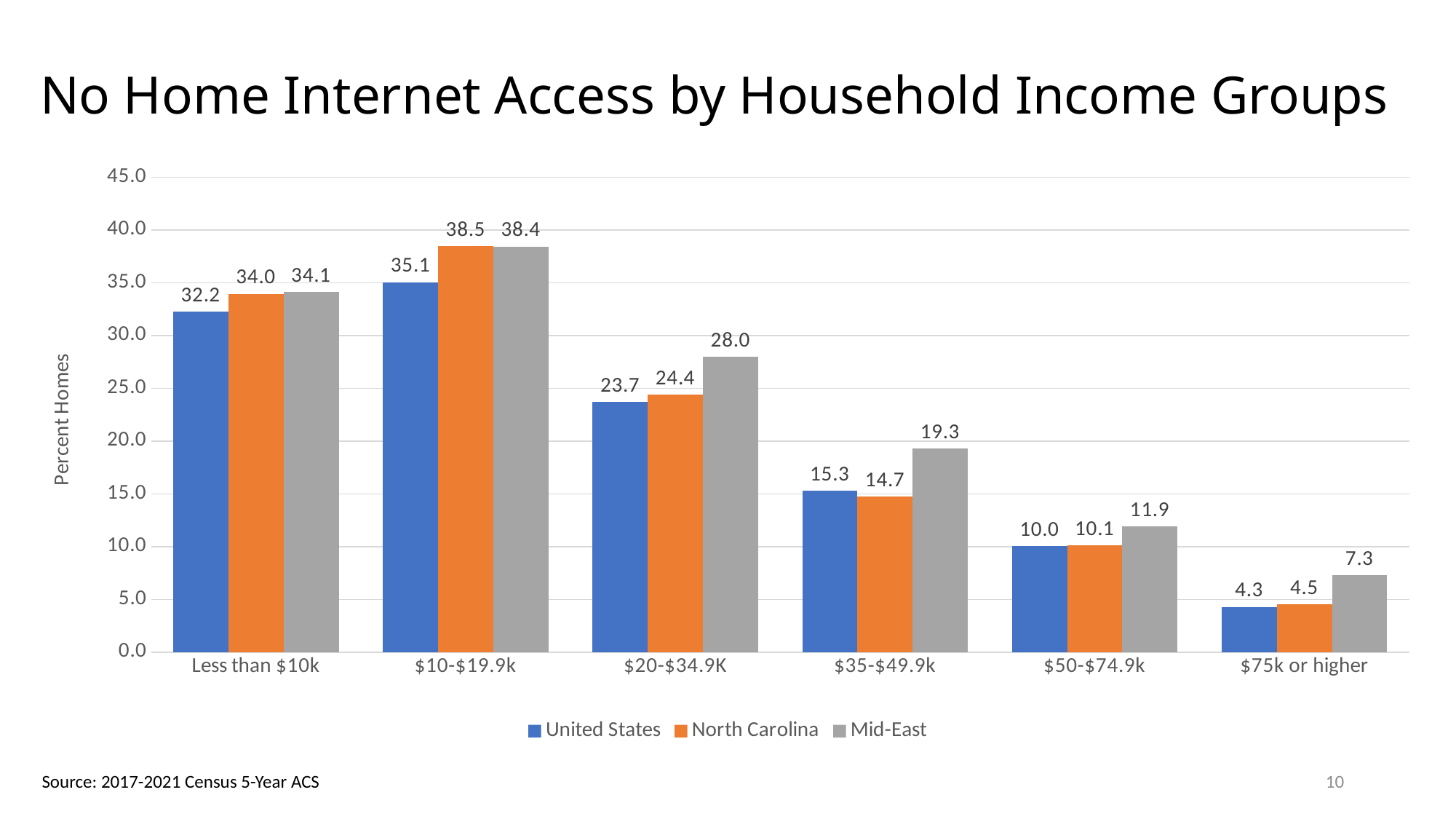
Which income group has the lowest value for the Mid-East series? $75k or higher How many series does the legend list? 3 Which income group has the highest value for the United States series? $10-$19.9k What is the value for North Carolina in the $20-$34.9K income group? 24.4 What is the value for United States in the $35-$49.9k income group? 15.3 Do the Mid-East values rise or fall as income groups increase along the x axis? Fall (after rising from 34.1 to 38.4 in the second group) How many income groups are shown on the x axis? 6 What is the label of the y axis? Percent Homes What is the value for Mid-East in the $75k or higher income group? 7.3 What kind of chart is shown on the slide? Bar chart What is the difference between the Mid-East and United States values in the $20-$34.9K income group? 4.3 Which is larger in the $35-$49.9k income group: the United States value or the North Carolina value? United States